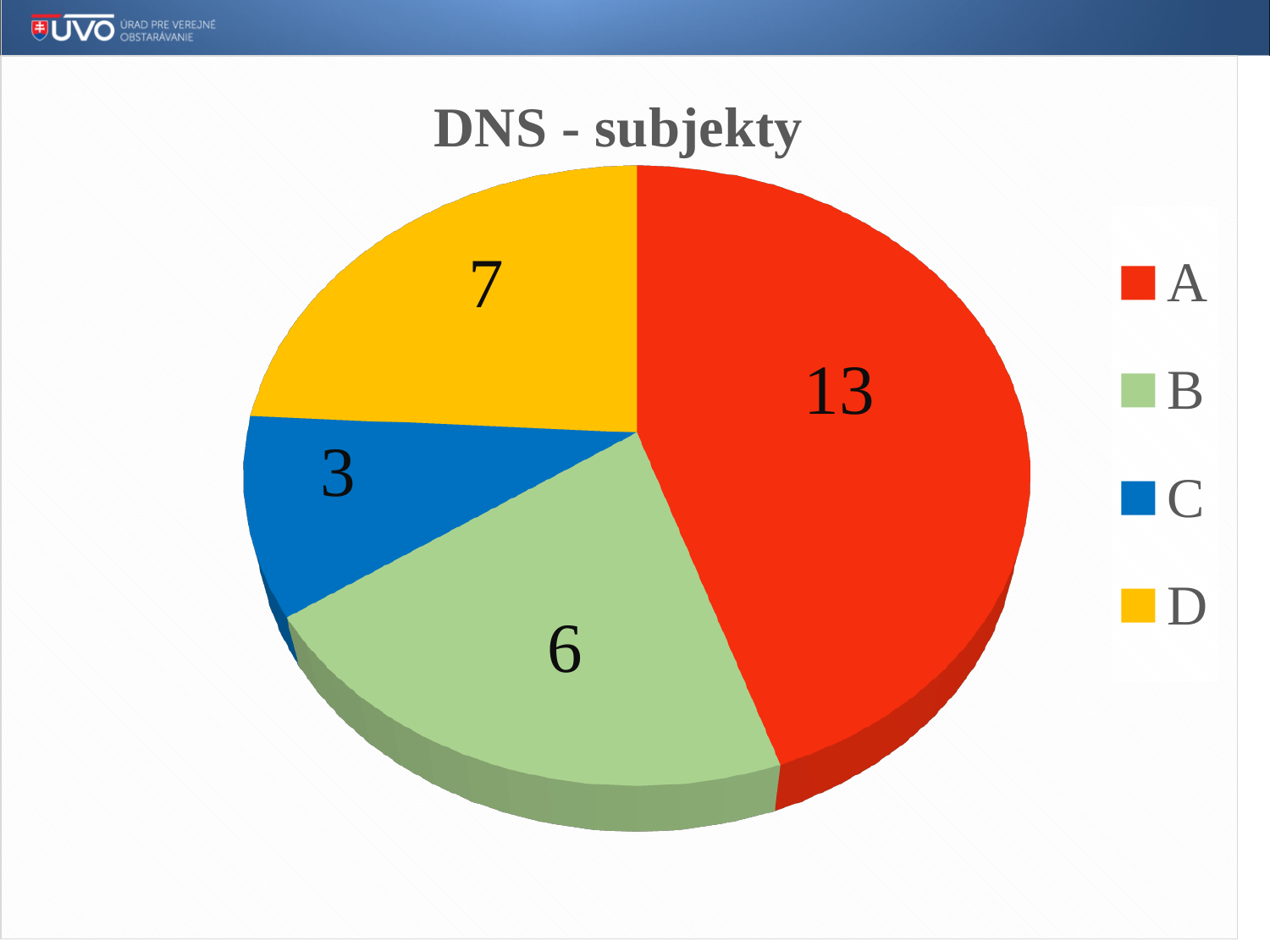
What is the value for category B in the pie chart? 6 Which category has the largest slice in the pie chart? A Which is larger, the value for B or the value for D? D What is the difference between the values for A and D? 6 What is the title of the chart? DNS - subjekty Which category has the smallest slice in the pie chart? C What is the value for category D in the pie chart? 7 What is the difference between the values for B and C? 3 How many categories are shown in the pie chart? 4 What is the value for category A in the pie chart? 13 What is the value for category C in the pie chart? 3 What type of chart is shown on the slide? Pie chart